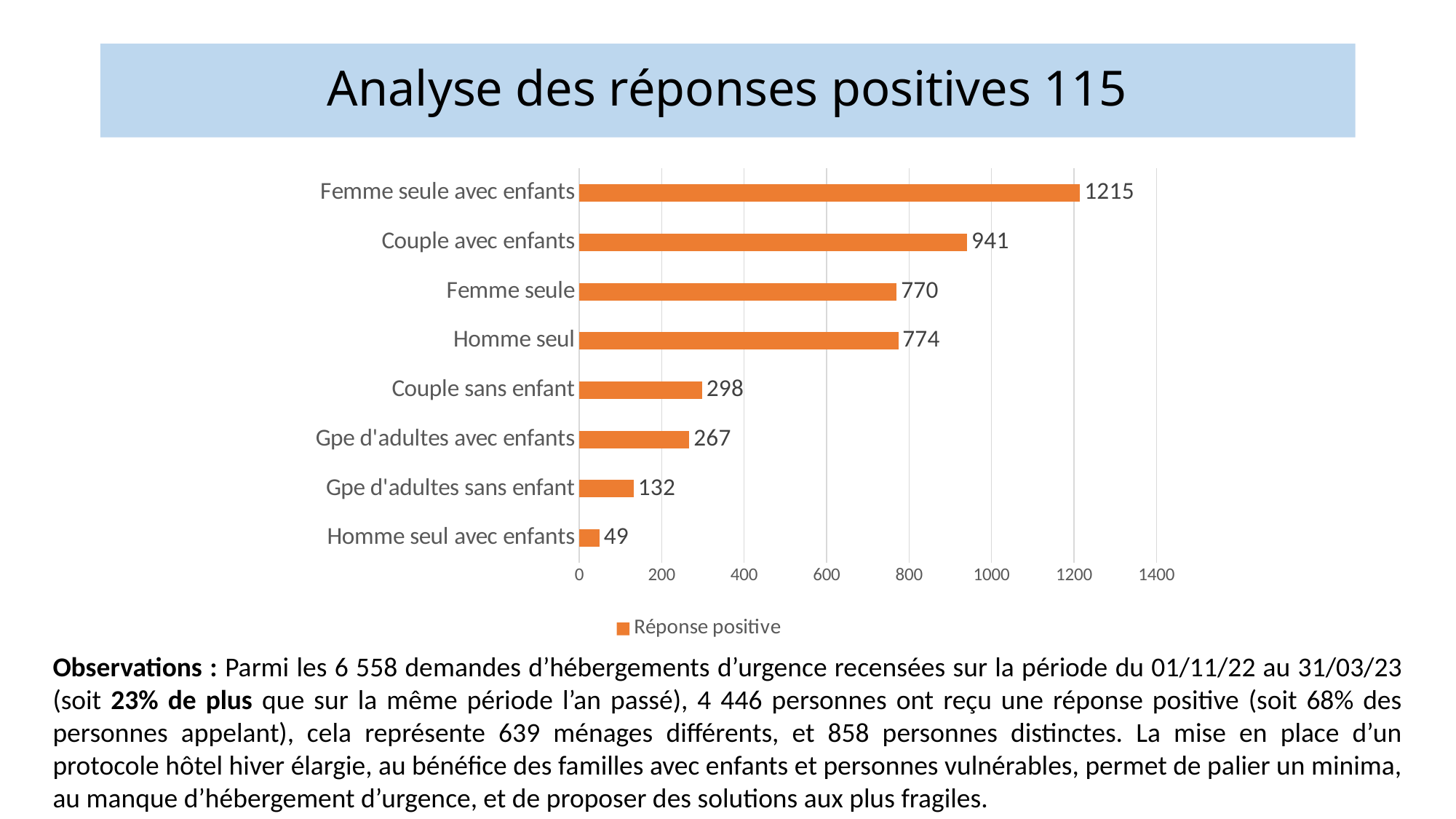
What kind of chart is shown on the slide? Bar chart What is the difference between the values for Femme seule avec enfants and Couple avec enfants? 274 What is the value for Gpe d'adultes sans enfant? 132 Which category has the lowest value? Homme seul avec enfants What is the value for Homme seul avec enfants? 49 What is the value for Femme seule avec enfants? 1215 What series name does the legend show? Réponse positive What is the difference between the values for Couple sans enfant and Gpe d'adultes avec enfants? 31 What is the value for Couple avec enfants? 941 How many categories are shown in the chart? 8 Which is larger, the value for Homme seul or the value for Femme seule? Homme seul Which category has the highest value? Femme seule avec enfants